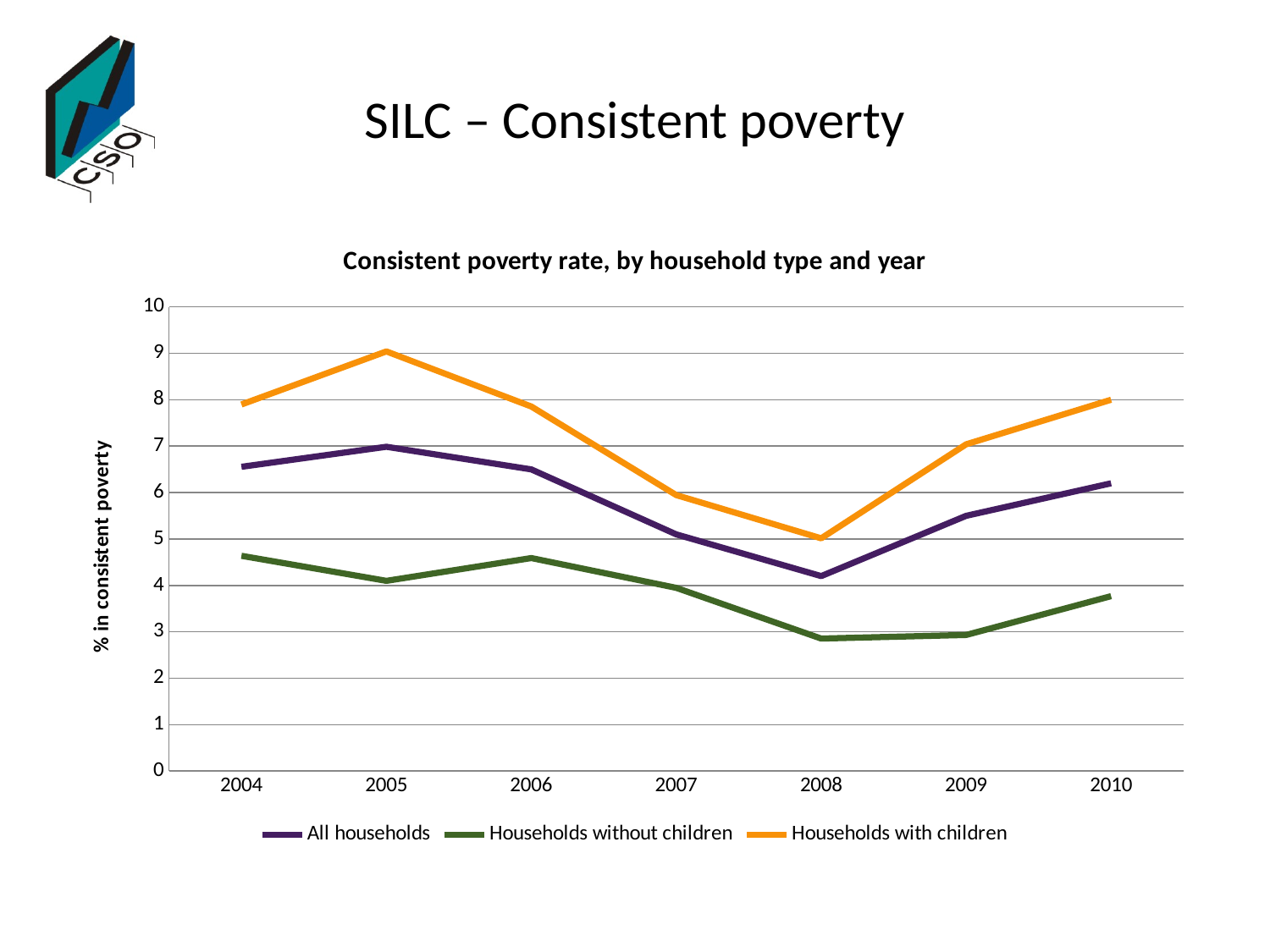
How many series does the legend list? 3 How many years are plotted along the x axis? 7 In which year is the value for All households lowest? 2008 What is the title of the y axis? % in consistent poverty In 2010, which is larger: the value for Households with children or the value for All households? Households with children In which year is the value for Households with children highest? 2005 Is the value for All households in 2008 greater or less than 5? less What type of chart is shown on the slide? Line chart Is the value for Households without children in 2008 greater or less than 4? less Does the value for All households rise or fall from 2005 to 2008? Fall Is the value for Households with children in 2005 greater or less than 8? greater In which year is the value for Households with children lowest? 2008